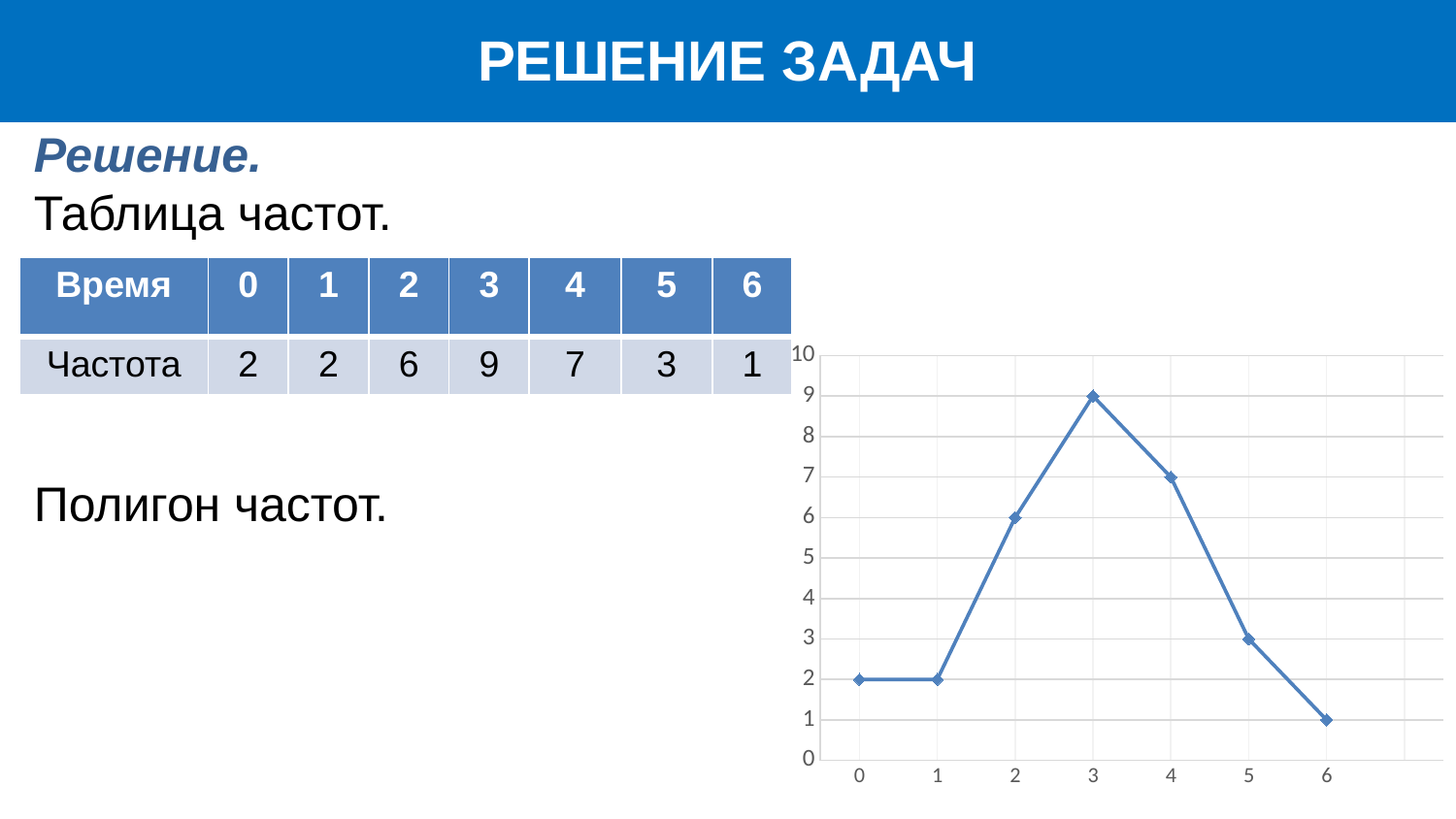
Is the value at x = 4 greater or less than 5? greater What is the value plotted at x = 2? 6 What kind of chart is shown on the slide? line chart How many data points are plotted on the chart? 7 What is the value plotted at x = 6? 1 Do the values rise or fall between x = 3 and x = 6? fall At which x value does the chart reach its lowest point? 6 At which x value does the chart reach its highest point? 3 What is the difference between the values at x = 3 and x = 4? 2 Which is larger, the value at x = 2 or the value at x = 5? x = 2 What is the maximum value shown on the vertical axis of the chart? 10 What is the value plotted at x = 3? 9